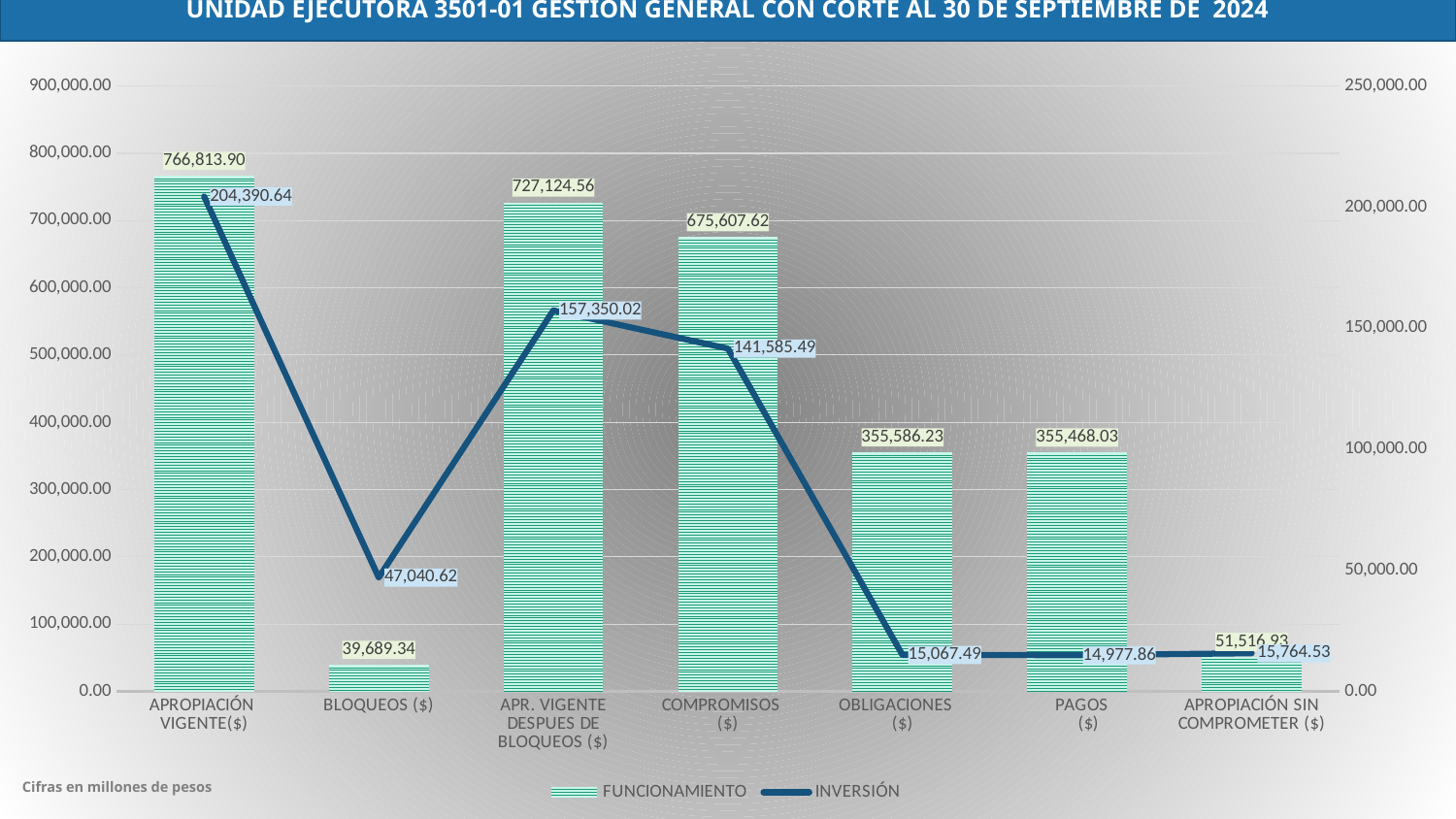
What is the FUNCIONAMIENTO value for BLOQUEOS ($)? 39,689.34 What kind of chart is shown on the slide? Combined bar and line chart How many series does the legend list? 2 Which category has the highest FUNCIONAMIENTO value? APROPIACIÓN VIGENTE($) Which has the larger FUNCIONAMIENTO value, BLOQUEOS ($) or APROPIACIÓN SIN COMPROMETER ($)? APROPIACIÓN SIN COMPROMETER ($) What is the FUNCIONAMIENTO value for APROPIACIÓN VIGENTE($)? 766,813.90 How many categories are shown on the x axis? 7 Which category has the highest INVERSIÓN value? APROPIACIÓN VIGENTE($) What is the difference between the FUNCIONAMIENTO values for APROPIACIÓN VIGENTE($) and APR. VIGENTE DESPUES DE BLOQUEOS ($)? 39,689.34 What is the INVERSIÓN value for APROPIACIÓN SIN COMPROMETER ($)? 15,764.53 What is the INVERSIÓN value for COMPROMISOS ($)? 141,585.49 Which category has the lowest FUNCIONAMIENTO value? BLOQUEOS ($)